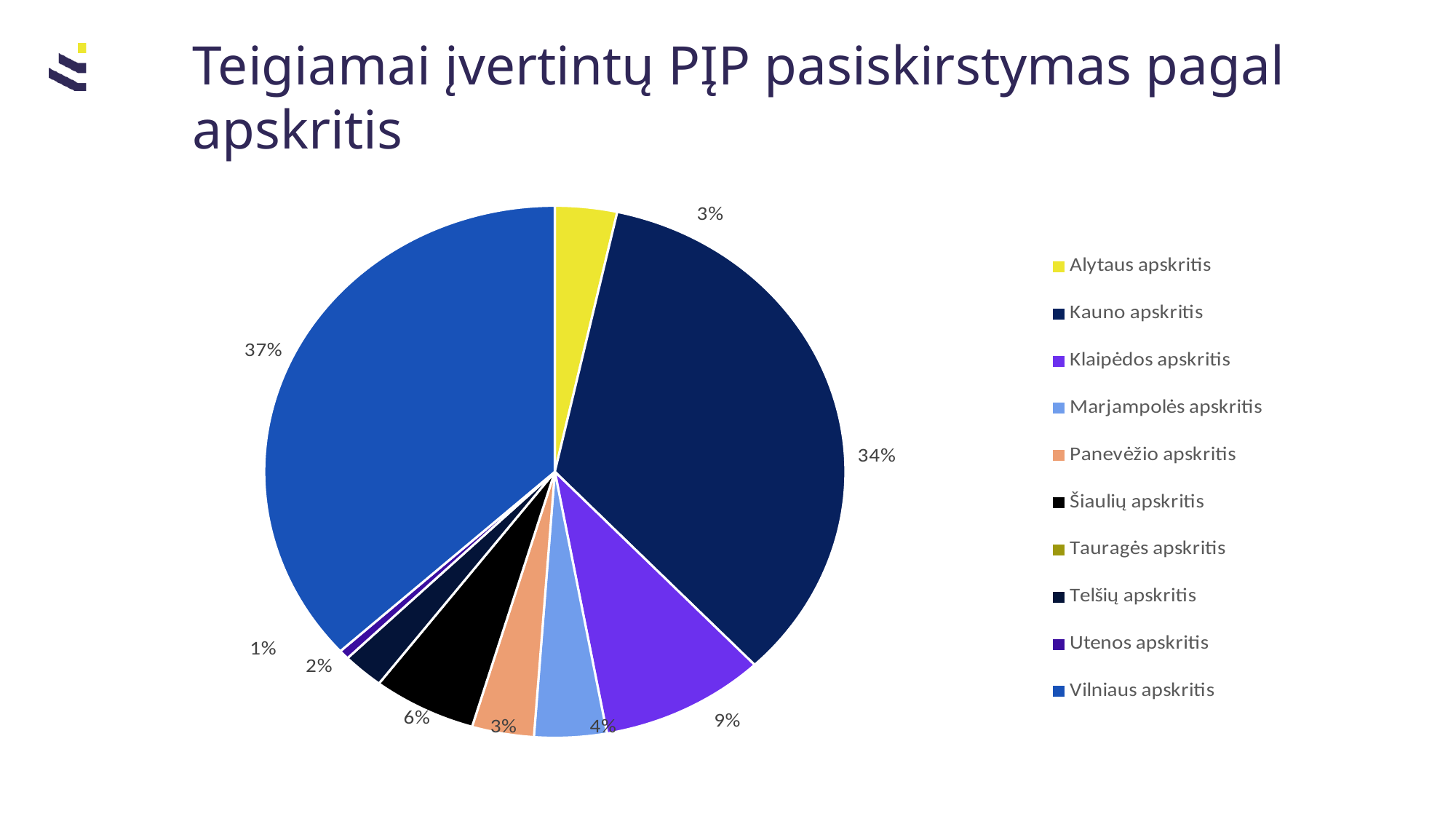
What share of the pie does Marijampolės apskritis have? 4% How many entries does the legend list? 10 Which region has the largest share of the pie? Vilniaus apskritis What share of the pie does Šiaulių apskritis have? 6% What kind of chart is shown on the slide? pie chart What is the title of the chart on the slide? Teigiamai įvertintų PĮP pasiskirstymas pagal apskritis What share of the pie does Kauno apskritis have? 34% What share of the pie does Vilniaus apskritis have? 37% What share of the pie does Klaipėdos apskritis have? 9% What is the difference between the shares of Vilniaus apskritis and Kauno apskritis? 3% What is the difference between the shares of Klaipėdos apskritis and Šiaulių apskritis? 3% Which is larger, the share for Kauno apskritis or the share for Klaipėdos apskritis? Kauno apskritis